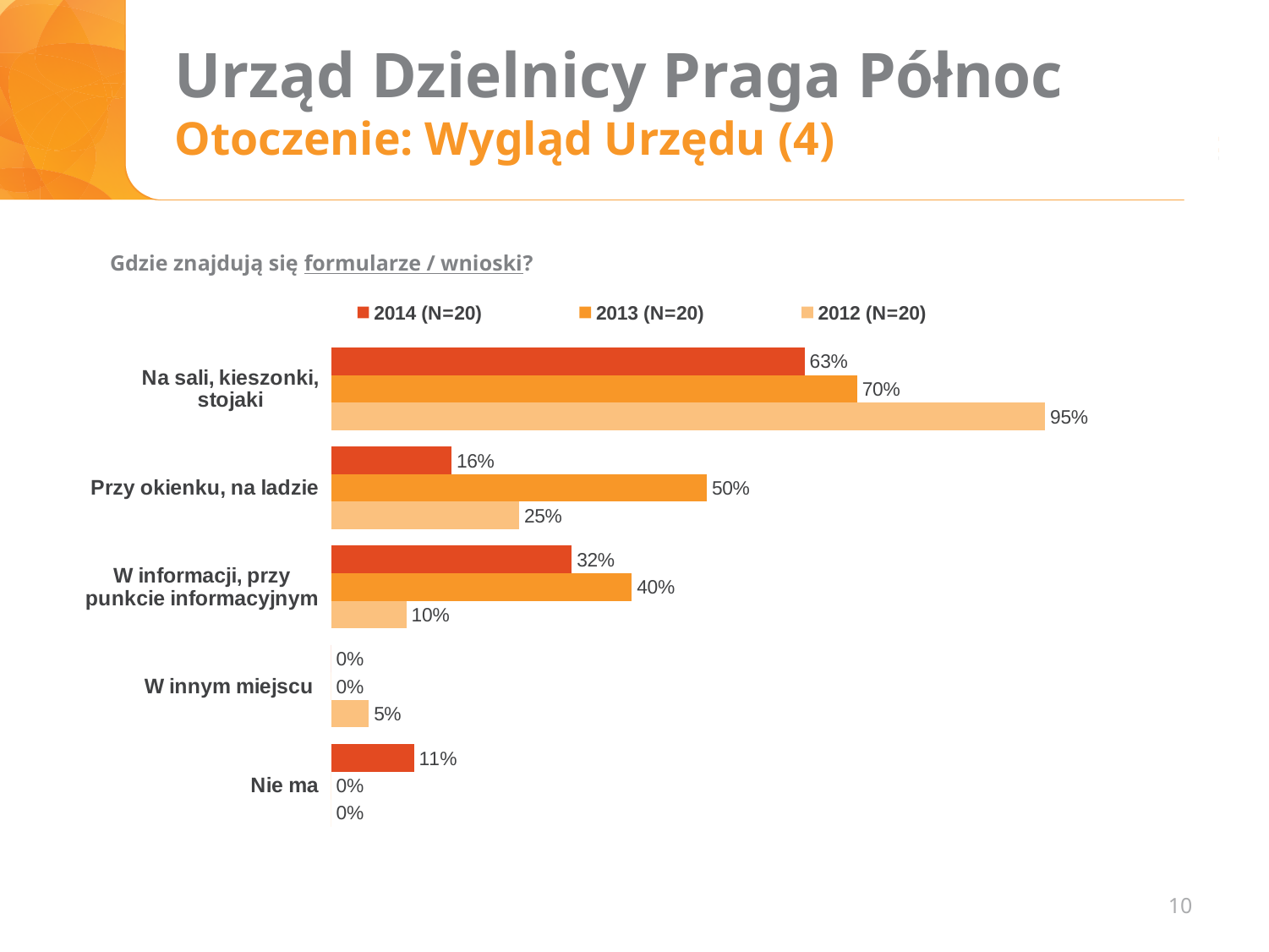
What is the value for "Przy okienku, na ladzie" in the 2013 (N=20) series? 50% What is the difference between the 2012 (N=20) and 2014 (N=20) values for "Na sali, kieszonki, stojaki"? 32% How many categories are shown on the chart? 5 What is the value for "W informacji, przy punkcie informacyjnym" in the 2012 (N=20) series? 10% What is the value for "Nie ma" in the 2014 (N=20) series? 11% Which is larger for "W informacji, przy punkcie informacyjnym": the 2013 (N=20) value or the 2014 (N=20) value? 2013 (N=20) Which category has the highest value in the 2012 (N=20) series? Na sali, kieszonki, stojaki Which category has the lowest value in the 2013 (N=20) series? W innym miejscu and Nie ma (both 0%) How many series does the legend list? 3 What question does the chart answer, as written above it? Gdzie znajdują się formularze / wnioski? What kind of chart is shown on the slide? Bar chart What is the value for "Na sali, kieszonki, stojaki" in the 2014 (N=20) series? 63%